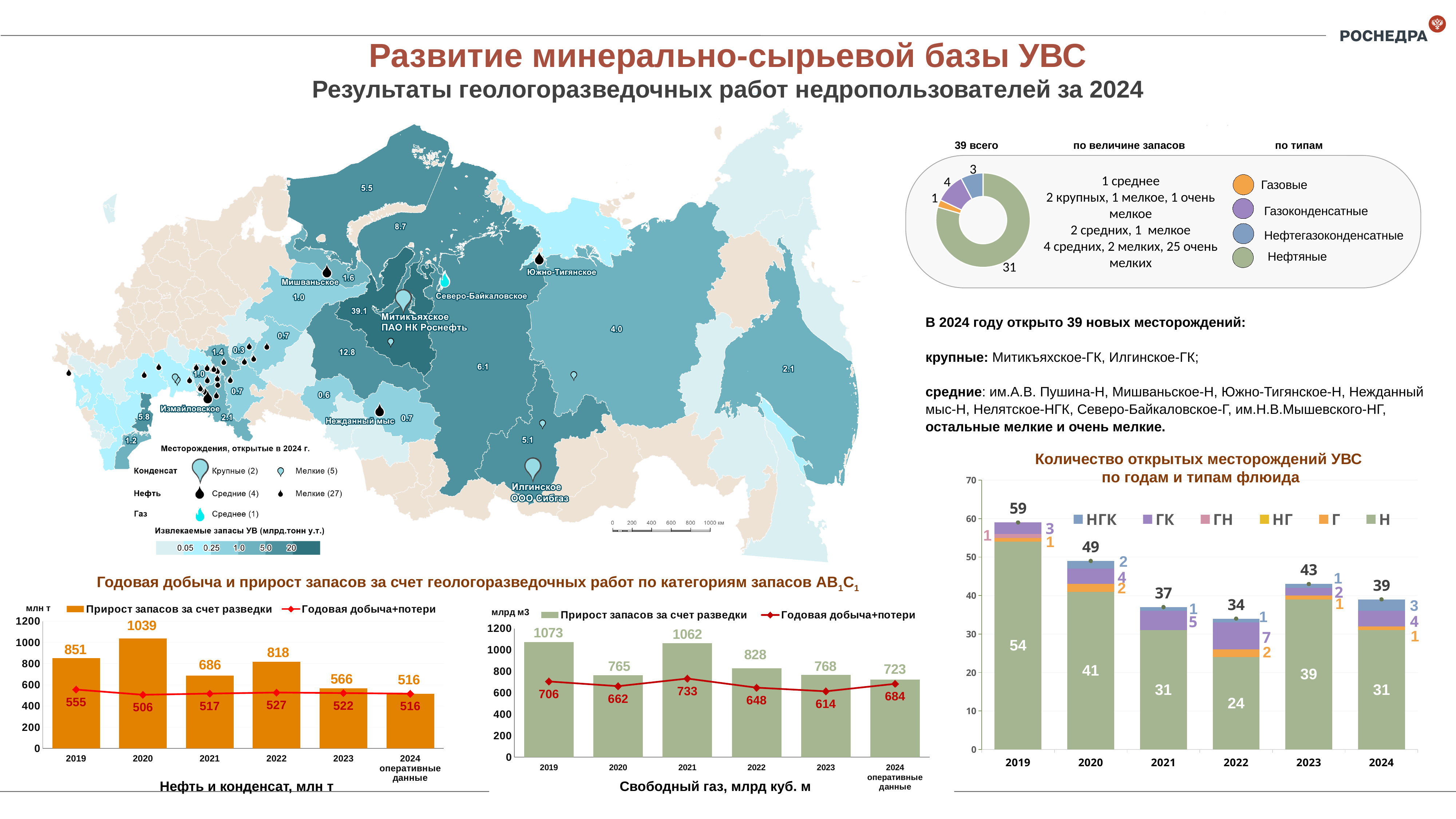
In the chart 'Нефть и конденсат, млн т', what is the difference between 'Прирост запасов за счет разведки' and 'Годовая добыча+потери' in 2019? 296 In the chart 'Свободный газ, млрд куб. м', what is the value of 'Прирост запасов за счет разведки' for 2021? 1062 How many series does the legend of the chart 'Количество открытых месторождений УВС по годам и типам флюида' list? 6 In the chart 'Нефть и конденсат, млн т', which year has the highest 'Прирост запасов за счет разведки'? 2020 In the chart 'Свободный газ, млрд куб. м', which year has the lowest 'Годовая добыча+потери'? 2023 In the chart 'Количество открытых месторождений УВС по годам и типам флюида', do the bar totals rise or fall from 2019 to 2022? fall How many years are shown on the x axis of the chart 'Количество открытых месторождений УВС по годам и типам флюида'? 6 In the chart 'Свободный газ, млрд куб. м', is 'Прирост запасов за счет разведки' larger in 2019 or in 2021? 2019 In the donut chart '39 всего', how many fields are 'Нефтяные'? 31 In the chart 'Количество открытых месторождений УВС по годам и типам флюида', what is the value of the 'Н' series for 2022? 24 In the chart 'Количество открытых месторождений УВС по годам и типам флюида', what is the total number of fields for 2023? 43 In the chart 'Нефть и конденсат, млн т', what is the value of 'Прирост запасов за счет разведки' for 2020? 1039